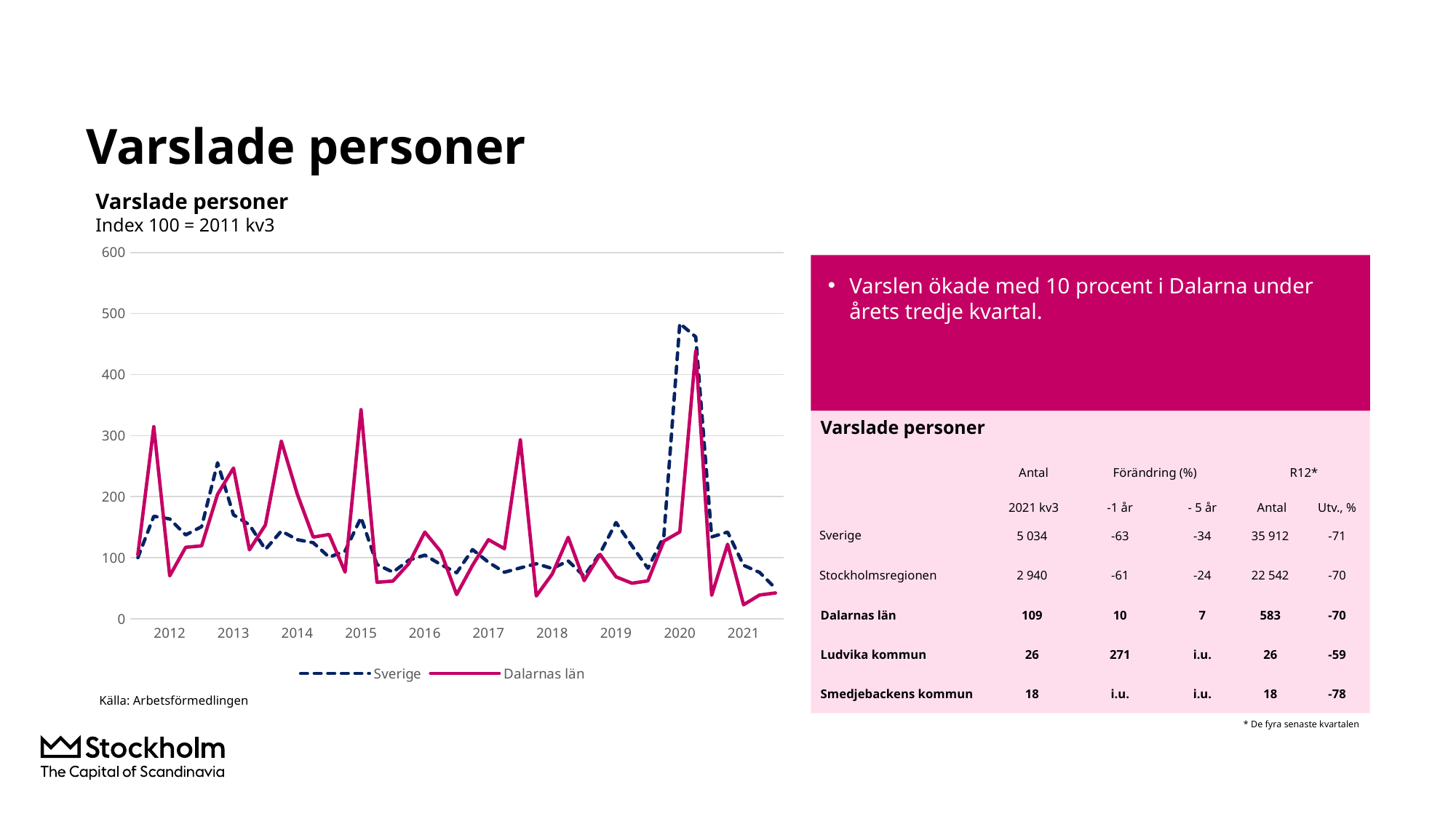
What are the two series shown in the chart legend? Sverige and Dalarnas län At the 2015 peak, which series has the higher value, Sverige or Dalarnas län? Dalarnas län Is the peak value for Sverige in 2020 greater or less than 400? greater What kind of chart is shown on the slide? Line chart How many series does the chart legend list? 2 In which year does the Dalarnas län series reach its highest value? 2020 Is the peak value for Dalarnas län in 2015 greater or less than 300? greater Is the peak value for Dalarnas län in 2020 greater or less than 400? greater Do the values for both series rise or fall from the 2020 peak to the end of 2021? Fall In which year does the Sverige series reach its highest value? 2020 What is the index base period stated under the chart title? Index 100 = 2011 kv3